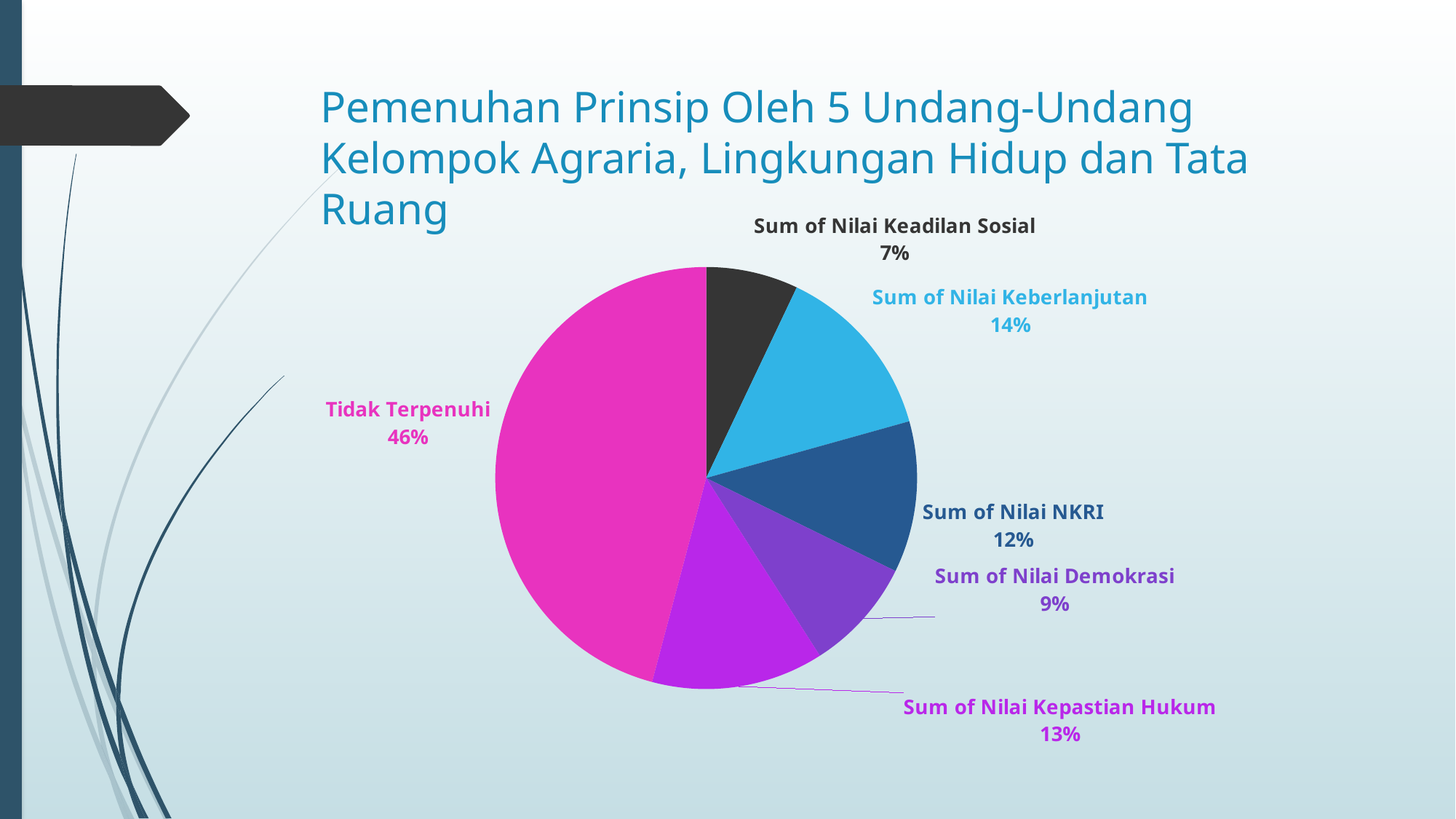
What is the value shown for Sum of Nilai Kepastian Hukum? 13% Which slice of the pie is the smallest? Sum of Nilai Keadilan Sosial How many slices does the pie chart have? 6 What share of the pie does Tidak Terpenuhi represent? 46% What kind of chart is shown on the slide? pie chart Which is larger, the share for Sum of Nilai Demokrasi or the share for Sum of Nilai NKRI? Sum of Nilai NKRI What is the value shown for Sum of Nilai NKRI? 12% What colour is the Tidak Terpenuhi slice? magenta (pink) What is the value shown for Sum of Nilai Keberlanjutan? 14% What is the difference between the shares of Tidak Terpenuhi and Sum of Nilai Keberlanjutan? 32% Which slice of the pie is the largest? Tidak Terpenuhi What is the difference between the shares of Sum of Nilai Kepastian Hukum and Sum of Nilai Keadilan Sosial? 6%